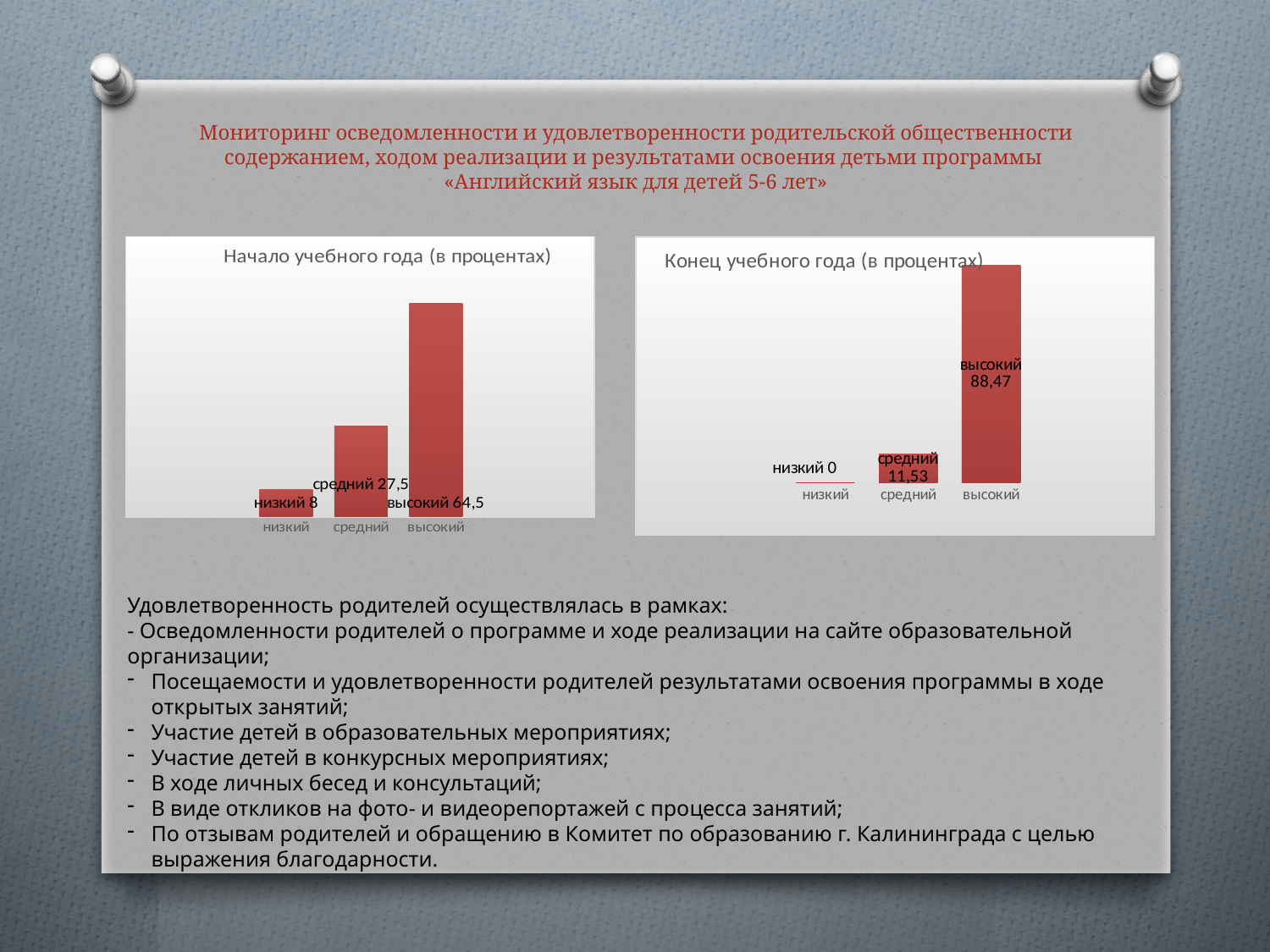
What type of chart is "Конец учебного года (в процентах)"? bar chart In the chart "Конец учебного года (в процентах)", what is the value for "высокий"? 88,47 In the chart "Конец учебного года (в процентах)", what is the difference between the values for "высокий" and "средний"? 76,94 In the chart "Конец учебного года (в процентах)", which category has the lowest value? низкий In the chart "Конец учебного года (в процентах)", what is the value for "средний"? 11,53 In the chart "Начало учебного года (в процентах)", which category has the highest value? высокий How many categories are shown in the chart "Начало учебного года (в процентах)"? 3 Which is larger: the value for "высокий" in the chart "Начало учебного года (в процентах)" or the value for "высокий" in the chart "Конец учебного года (в процентах)"? Конец учебного года (в процентах) In the chart "Начало учебного года (в процентах)", what is the difference between the values for "высокий" and "средний"? 37 In the chart "Начало учебного года (в процентах)", do the values rise or fall from "низкий" to "высокий"? rise In the chart "Начало учебного года (в процентах)", what is the value for "низкий"? 8 In the chart "Начало учебного года (в проценtах)", what is the value for "средний"? 27,5